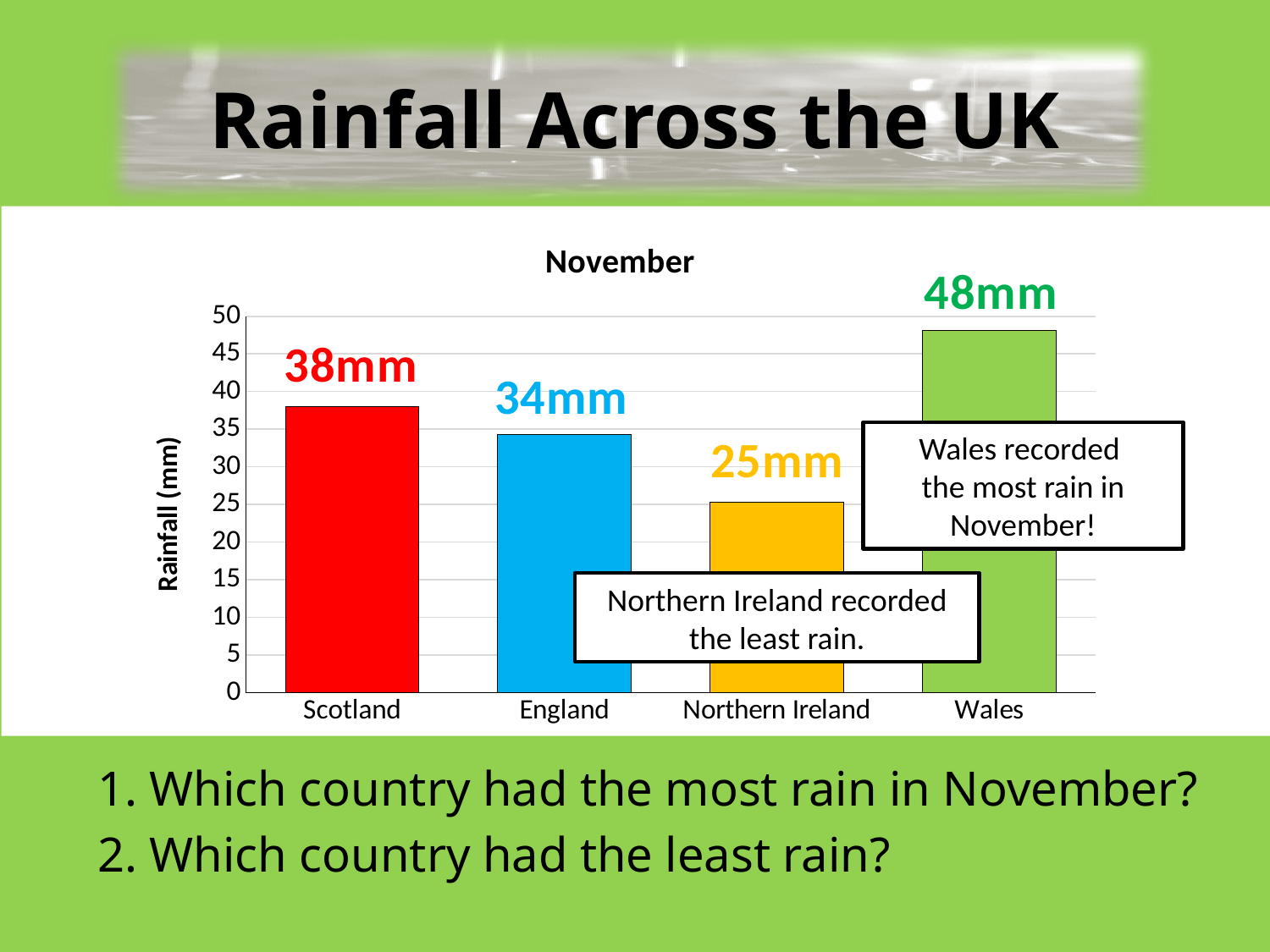
Which country has the lowest rainfall in the chart? Northern Ireland What is the rainfall value for England? 34mm What kind of chart is shown on the slide? Bar chart How many countries are shown in the chart? 4 What is the rainfall value for Northern Ireland? 25mm Which country has the highest rainfall in the chart? Wales What is the rainfall value for Wales? 48mm Which has more rainfall, Scotland or England? Scotland What is the title of the chart? November What is the difference in rainfall between Scotland and England? 4mm What is the rainfall value for Scotland? 38mm What is the difference in rainfall between Wales and Northern Ireland? 23mm